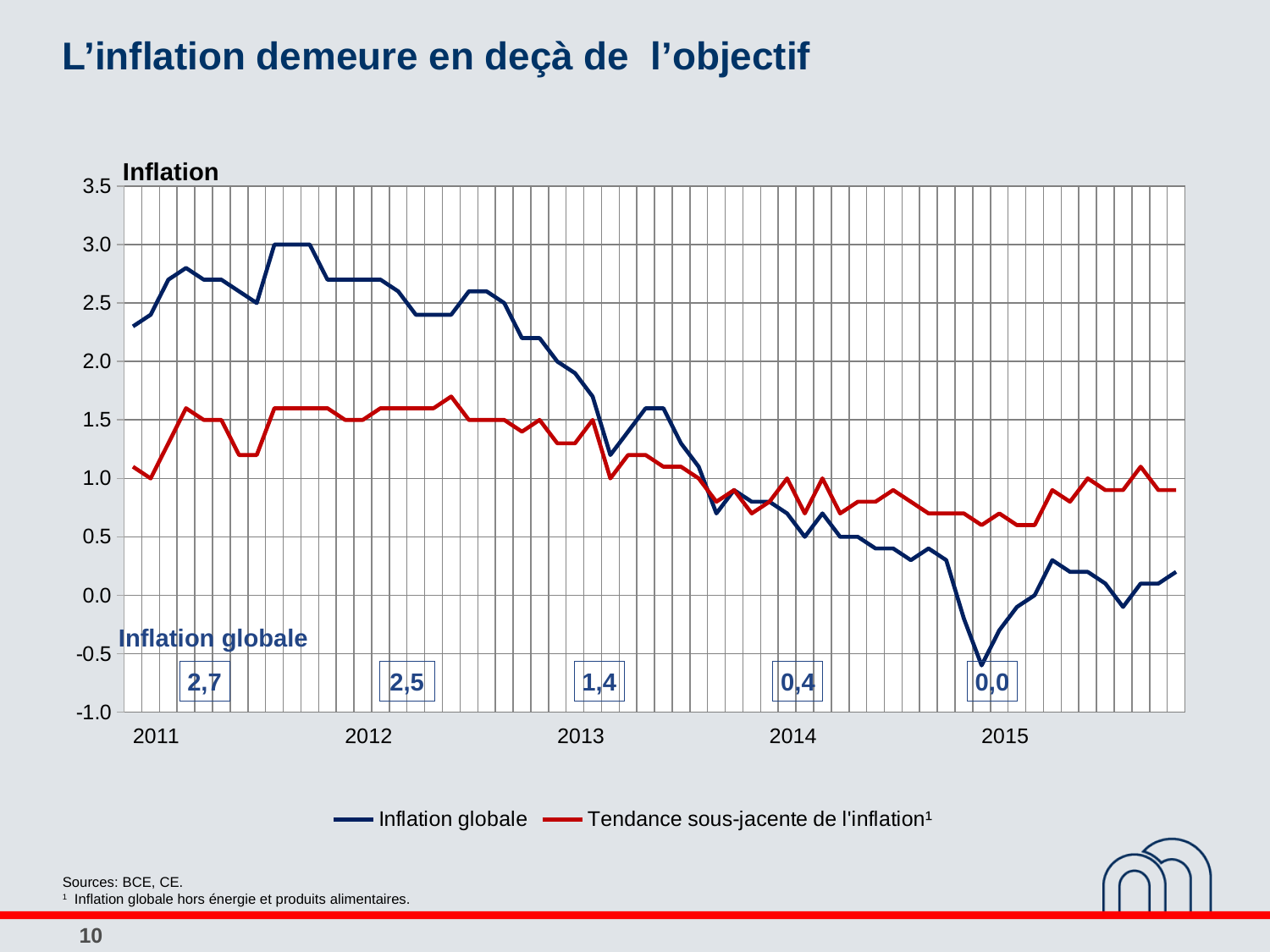
What kind of chart is shown on the slide? line chart What is the annual value shown for Inflation globale in 2011? 2,7 How many years are labelled on the x axis? 5 Which year has the highest annual Inflation globale value among the labelled years? 2011 Is the value of Inflation globale at the start of 2011 greater or less than 2.0? greater Do the annual Inflation globale values rise or fall from 2011 to 2015? fall What is the difference between the annual Inflation globale values for 2011 and 2012? 0,2 What is the annual value shown for Inflation globale in 2013? 1,4 How many series does the legend list? 2 What is the difference between the annual Inflation globale values for 2013 and 2014? 1,0 Which year has the lowest annual Inflation globale value among the labelled years? 2015 What is the annual value shown for Inflation globale in 2015? 0,0